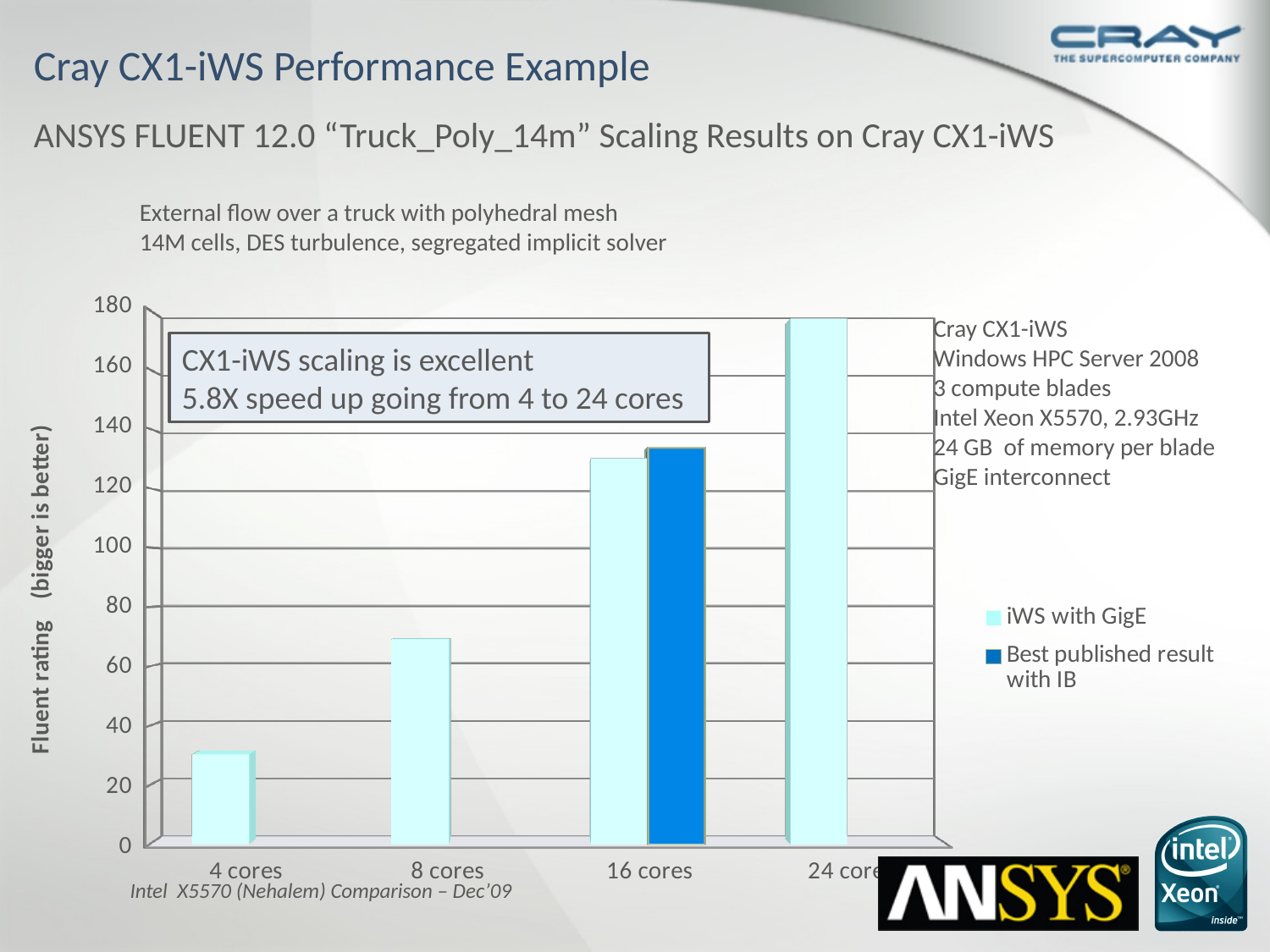
Which core count has the lowest iWS with GigE Fluent rating? 4 cores Is the iWS with GigE value for 16 cores greater or less than 120? greater What kind of chart is shown on the slide? bar chart Does the iWS with GigE Fluent rating rise or fall as the number of cores increases? rises Which core count has the highest iWS with GigE Fluent rating? 24 cores How many series does the legend list? 2 What is the label on the vertical axis of the chart? Fluent rating (bigger is better) Is the iWS with GigE value for 24 cores greater or less than 160? greater Which has a larger iWS with GigE Fluent rating, 8 cores or 16 cores? 16 cores How many core-count categories are shown on the x axis? 4 Is the iWS with GigE value for 4 cores greater or less than 40? less